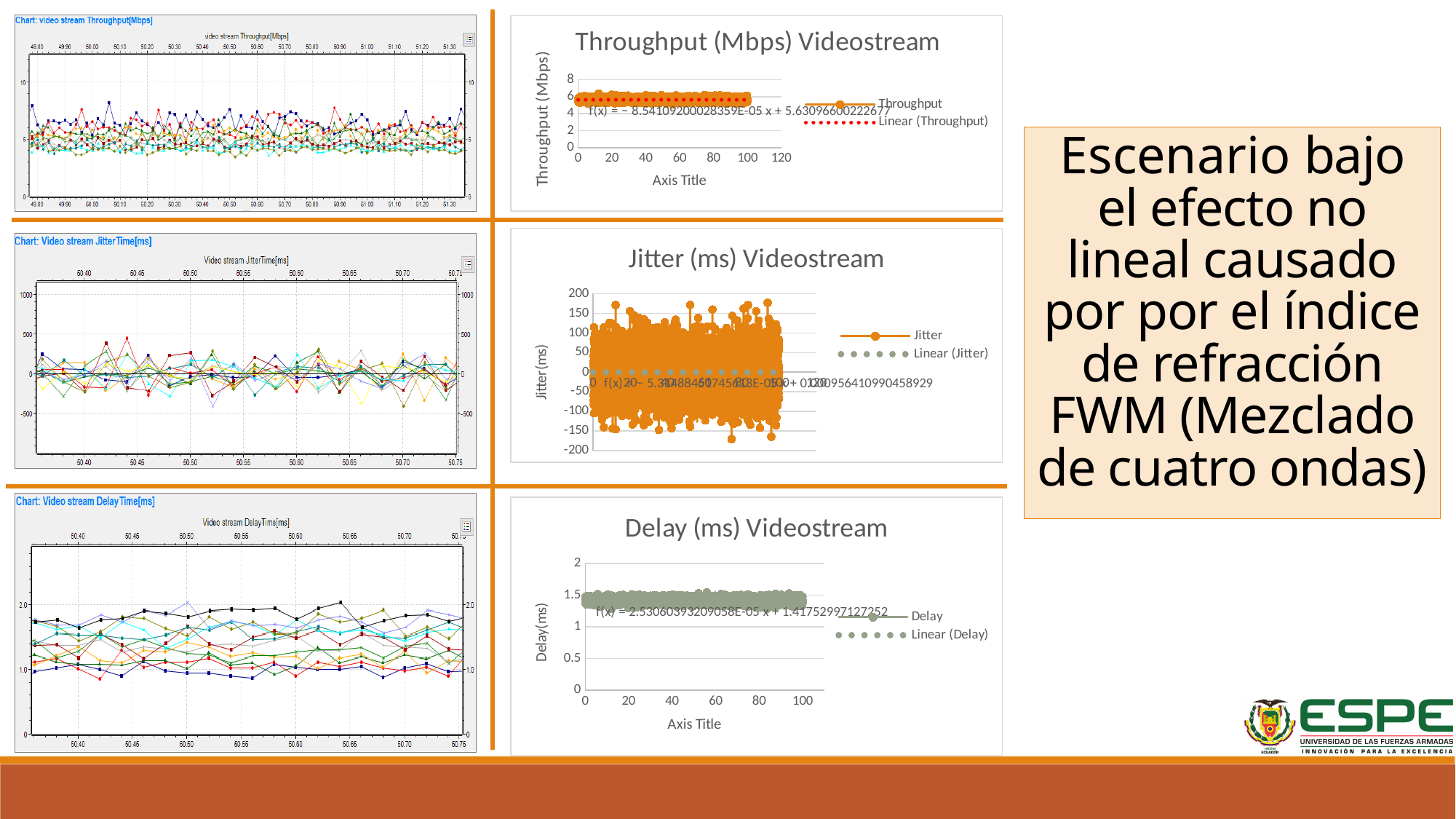
How many series does the legend of the "Throughput (Mbps) Videostream" chart list? 2 What is the label of the vertical axis of the "Delay (ms) Videostream" chart? Delay(ms) What is the title of the middle chart on the right side of the slide? Jitter (ms) Videostream What is the lowest value shown on the vertical axis of the "Jitter (ms) Videostream" chart? -200 In the "Throughput (Mbps) Videostream" chart, are the plotted throughput values greater or less than 4 Mbps? greater What is the highest value shown on the vertical axis of the "Jitter (ms) Videostream" chart? 200 In the "Throughput (Mbps) Videostream" chart, are the plotted throughput values greater or less than 8 Mbps? less In the "Delay (ms) Videostream" chart, are the plotted delay values greater or less than 1 ms? greater What are the two legend entries of the "Jitter (ms) Videostream" chart? Jitter and Linear (Jitter) What is the highest tick value on the horizontal axis of the "Throughput (Mbps) Videostream" chart? 120 How many series does the legend of the "Delay (ms) Videostream" chart list? 2